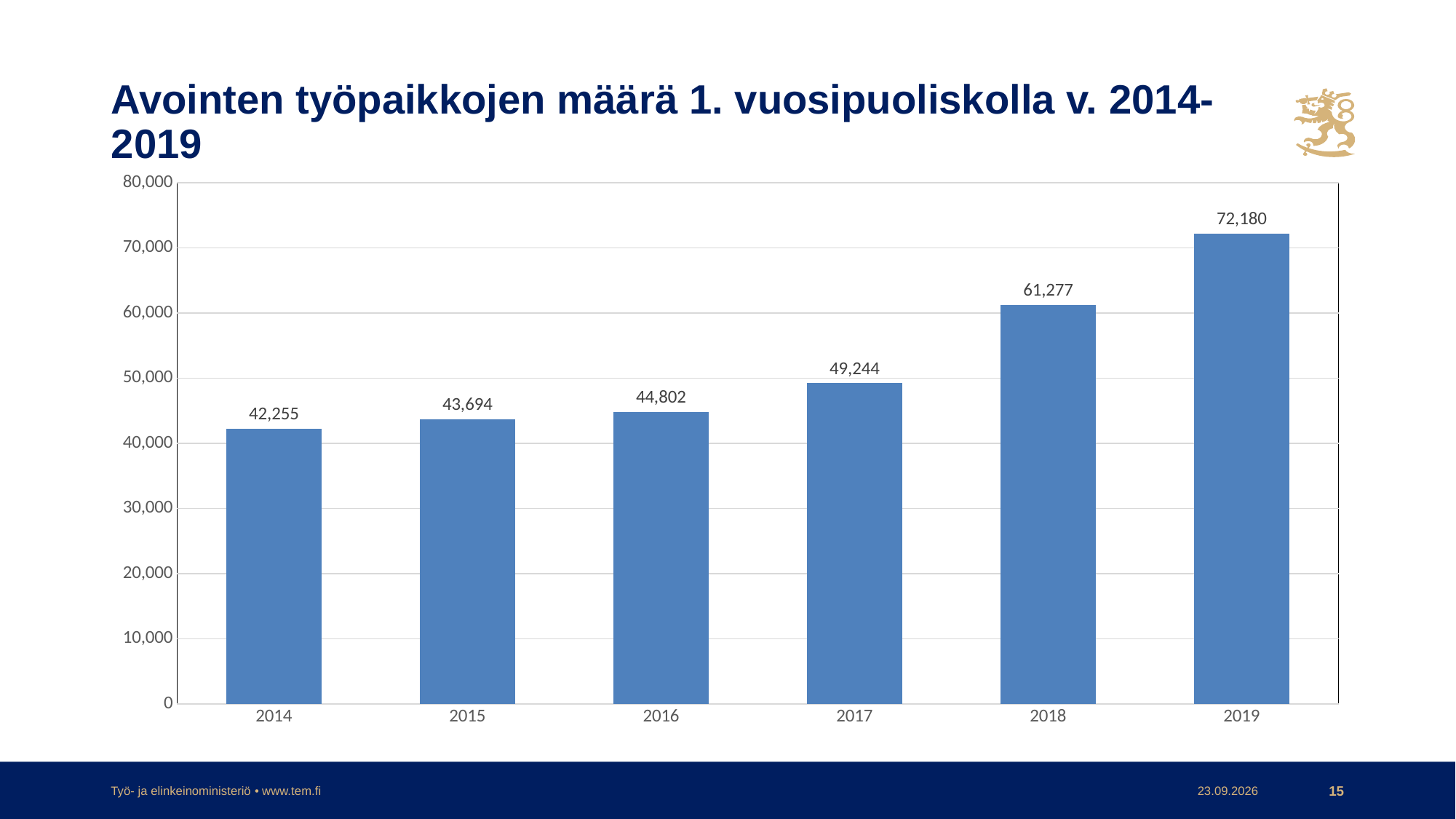
Do the values rise or fall from 2014 to 2019? rise What is the value for 2014? 42,255 Which is larger, the value for 2018 or the value for 2017? 2018 Which year has the lowest value? 2014 Which year has the highest value? 2019 What kind of chart is shown on the slide? bar chart What is the difference between the values for 2016 and 2015? 1,108 Is the value for 2018 greater or less than 60,000? greater How many years are shown on the x axis? 6 What is the value for 2017? 49,244 What is the difference between the values for 2019 and 2018? 10,903 What is the value for 2019? 72,180